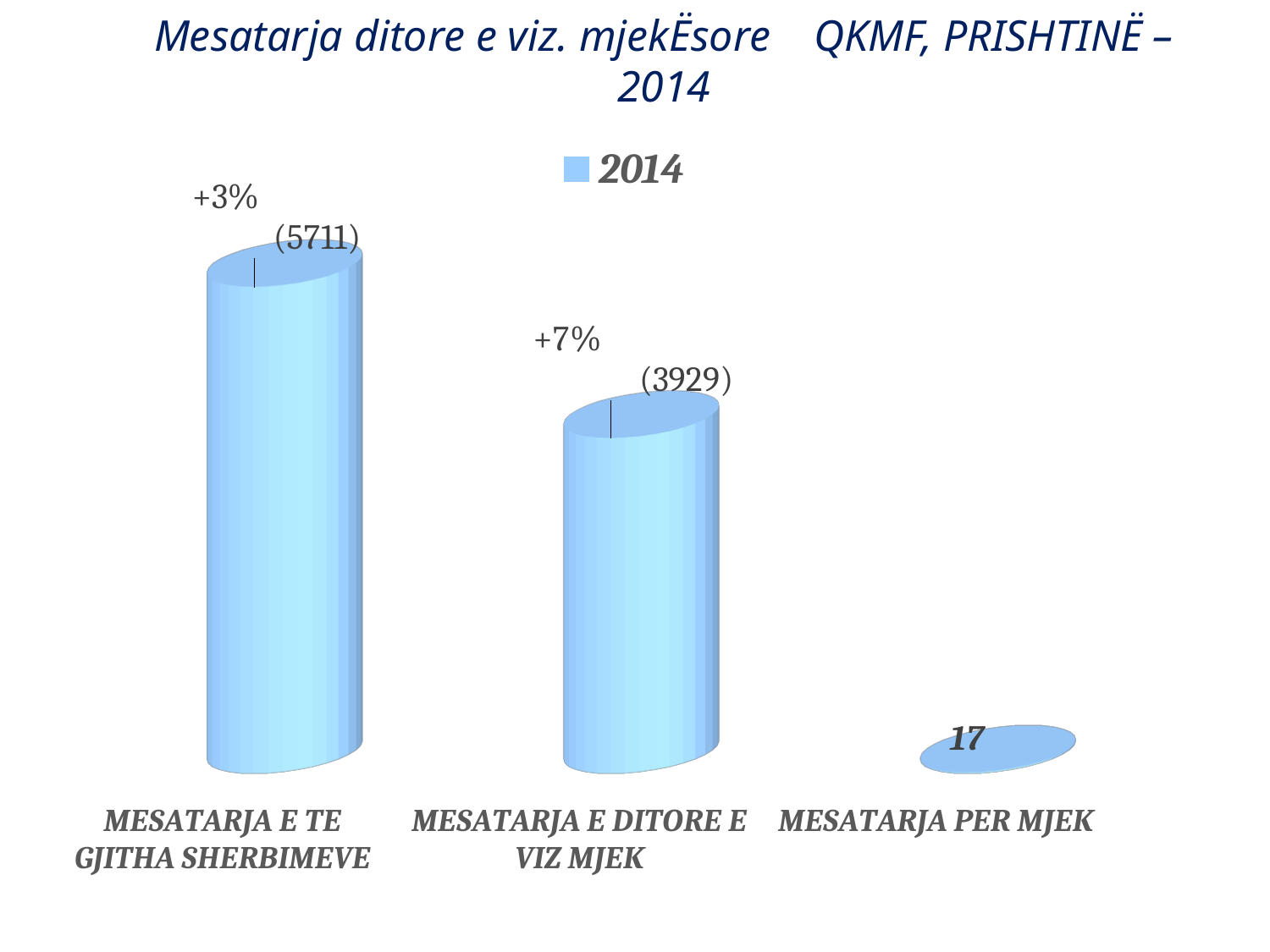
Which category has the highest value? MESATARJA E TE GJITHA SHERBIMEVE Which is larger, the value for MESATARJA E DITORE E VIZ MJEK or the value for MESATARJA PER MJEK? MESATARJA E DITORE E VIZ MJEK What kind of chart is shown on the slide? Bar chart How many categories are shown on the x axis? 3 What is the difference between the values for MESATARJA E TE GJITHA SHERBIMEVE and MESATARJA E DITORE E VIZ MJEK? 1782 What series name is shown in the legend? 2014 What is the value for MESATARJA PER MJEK? 17 How many series does the legend list? 1 What is the value for MESATARJA E DITORE E VIZ MJEK? 3929 What percentage change is annotated above the bar for MESATARJA E DITORE E VIZ MJEK? +7% Which category has the lowest value? MESATARJA PER MJEK What is the value for MESATARJA E TE GJITHA SHERBIMEVE? 5711